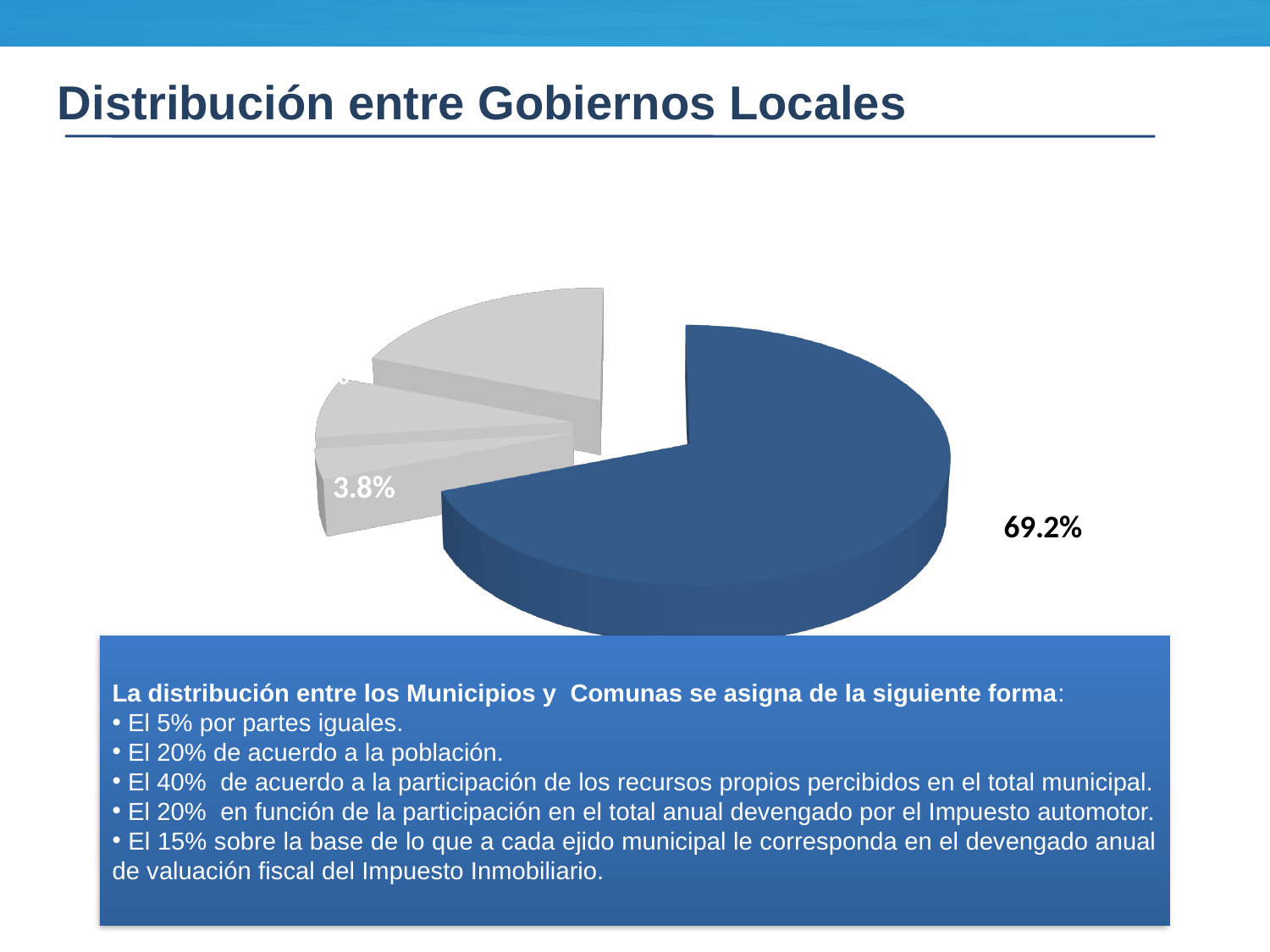
Which is larger, the slice labelled 69.2% or the slice labelled 3.8%? 69.2% What is the difference between the slice labelled 69.2% and the slice labelled 3.8%? 65.4% What is the title of the slide containing the pie chart? Distribución entre Gobiernos Locales What is the smallest percentage value printed on the pie chart? 3.8% What colour is the largest slice of the pie chart? blue What kind of chart is shown on the slide? pie chart Does the blue slice represent more or less than half of the pie? more What percentage is shown for the largest slice of the pie chart? 69.2%